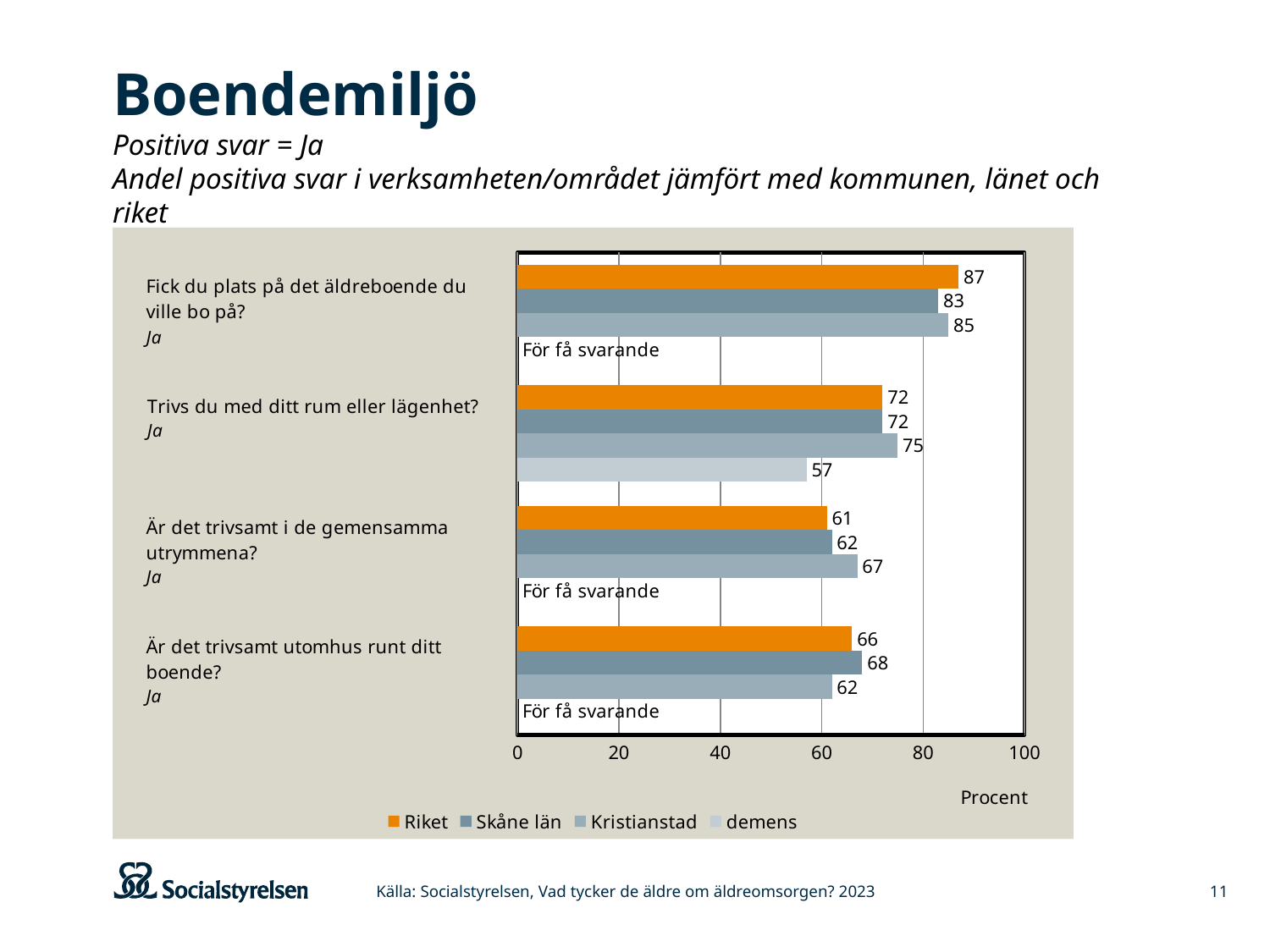
What text is shown in place of the demens bar on "Är det trivsamt i de gemensamma utrymmena?"? För få svarande What is the value for demens on "Trivs du med ditt rum eller lägenhet?"? 57 What is the difference between Kristianstad and demens on "Trivs du med ditt rum eller lägenhet?"? 18 What is the value for Kristianstad on "Är det trivsamt i de gemensamma utrymmena?"? 67 How many questions (categories) are shown on the chart? 4 Which is larger on "Fick du plats på det äldreboende du ville bo på?": Riket or Skåne län? Riket Which series has the lowest value on "Är det trivsamt utomhus runt ditt boende?"? Kristianstad How many series does the legend list? 4 What is the value for Skåne län on "Är det trivsamt utomhus runt ditt boende?"? 68 Which series has the highest value on "Trivs du med ditt rum eller lägenhet?"? Kristianstad What kind of chart is shown on the slide? Bar chart What is the value for Riket on "Fick du plats på det äldreboende du ville bo på?"? 87